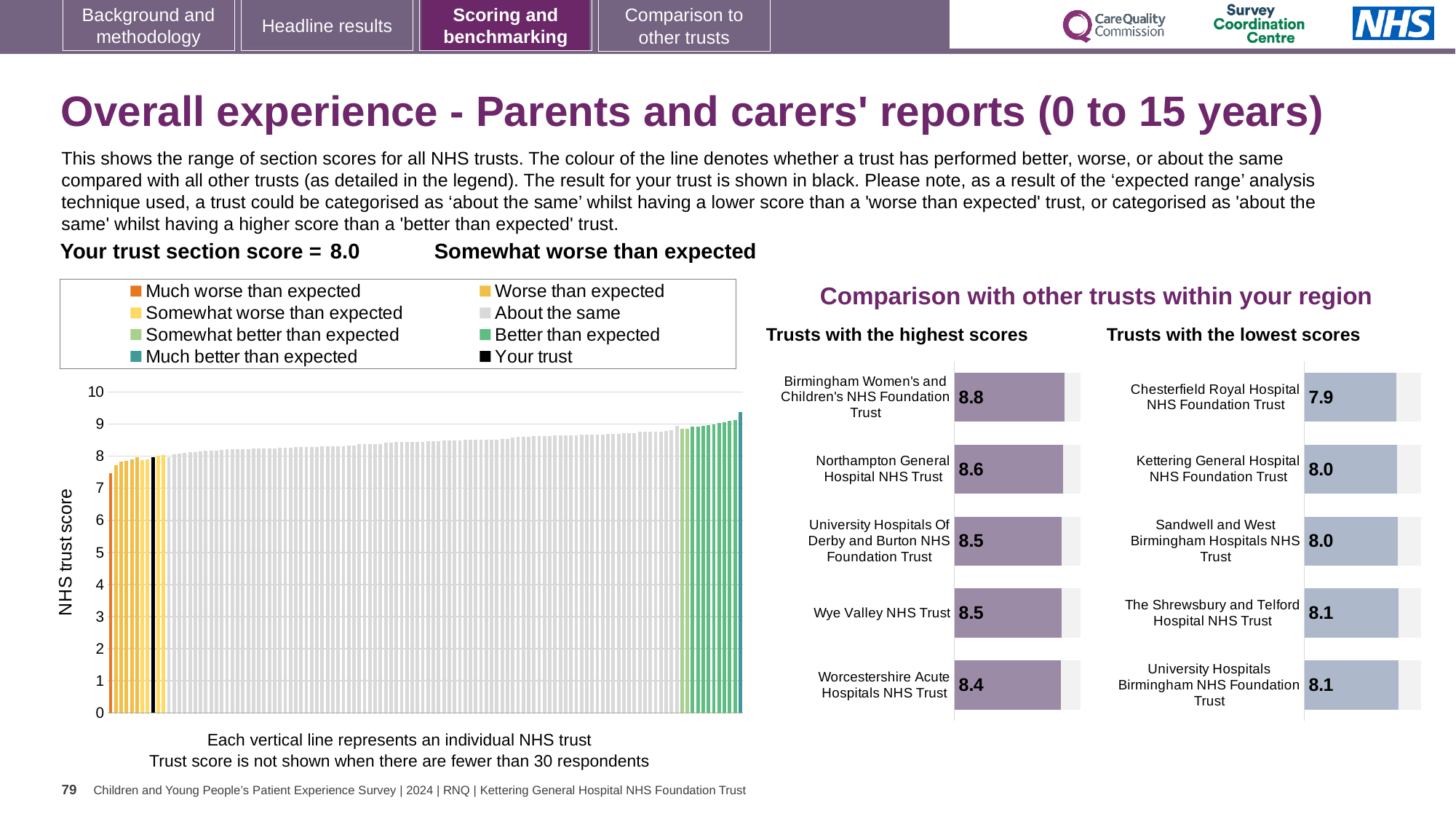
In the 'Trusts with the lowest scores' chart, which trust has the lowest score? Chesterfield Royal Hospital NHS Foundation Trust In the main chart on the left showing the range of section scores, is the value of the tallest bar greater or less than 9? greater In the 'Trusts with the highest scores' chart, what is the score for Birmingham Women's and Children's NHS Foundation Trust? 8.8 In the 'Trusts with the lowest scores' chart, what is the score for Chesterfield Royal Hospital NHS Foundation Trust? 7.9 In the 'Trusts with the highest scores' chart, what is the score for Worcestershire Acute Hospitals NHS Trust? 8.4 In the 'Trusts with the lowest scores' chart, what is the difference between the scores of University Hospitals Birmingham NHS Foundation Trust and Chesterfield Royal Hospital NHS Foundation Trust? 0.2 In the 'Trusts with the highest scores' chart, which trust has the highest score? Birmingham Women's and Children's NHS Foundation Trust In the 'Trusts with the lowest scores' chart, which has the larger score: Chesterfield Royal Hospital NHS Foundation Trust or The Shrewsbury and Telford Hospital NHS Trust? The Shrewsbury and Telford Hospital NHS Trust How many entries does the legend of the main chart on the left list? 8 In the main chart on the left showing the range of section scores, what is the section score for your trust (the black bar)? 8.0 In the 'Trusts with the highest scores' chart, what is the difference between the scores of Birmingham Women's and Children's NHS Foundation Trust and Worcestershire Acute Hospitals NHS Trust? 0.4 In the 'Trusts with the highest scores' chart, how many trusts are shown? 5